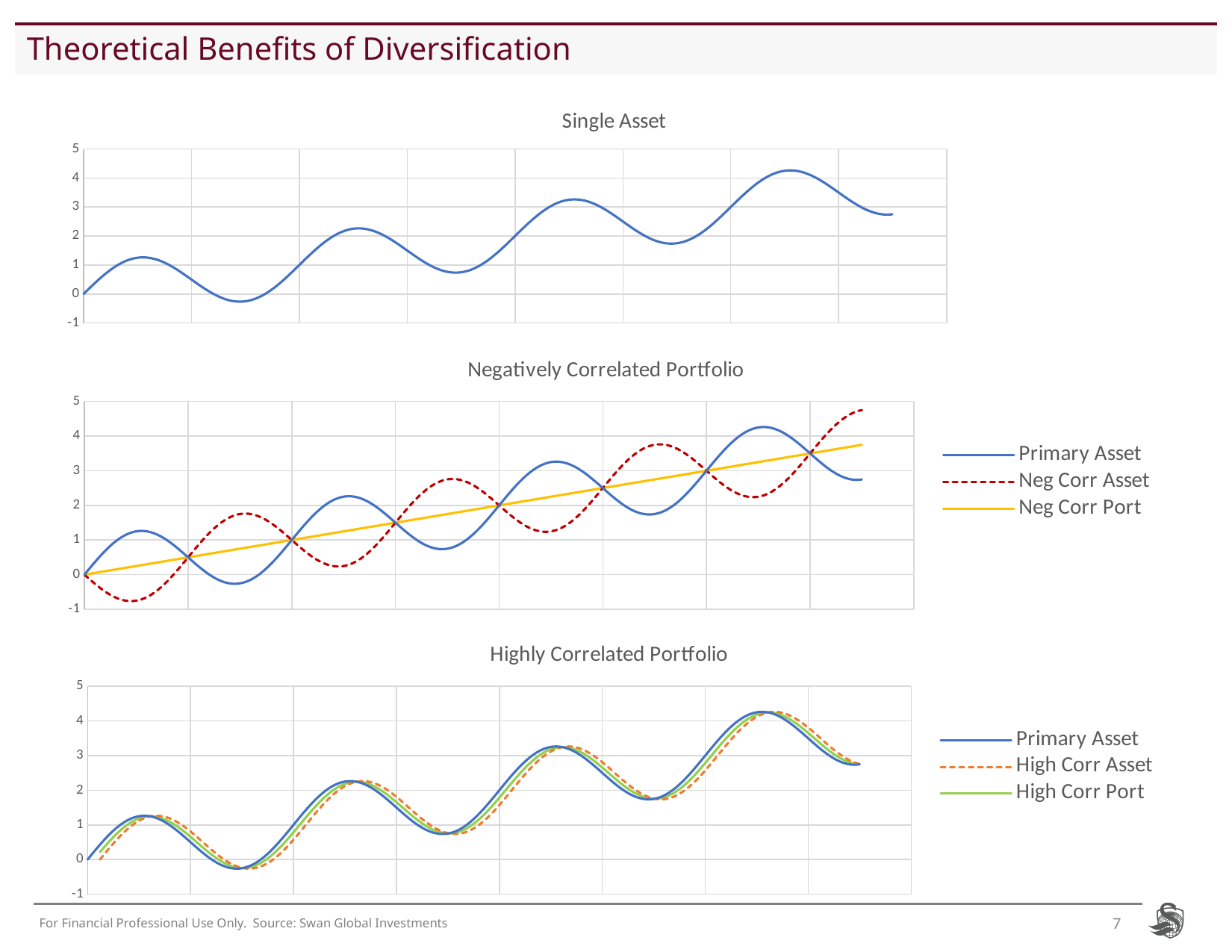
What is the highest value shown on the y axis of the "Single Asset" chart? 5 How many series does the legend of the "Negatively Correlated Portfolio" chart list? 3 In the "Highly Correlated Portfolio" chart, which series is drawn as a green solid line? High Corr Port In the "Negatively Correlated Portfolio" chart, is the lowest point of the Neg Corr Asset line greater or less than 0? less In the "Single Asset" chart, does the line generally rise or fall from left to right? rise In the "Single Asset" chart, is the highest peak of the line greater or less than 4? greater In the "Highly Correlated Portfolio" chart, is the final value of the Primary Asset line greater or less than 2? greater How many series does the legend of the "Highly Correlated Portfolio" chart list? 3 What kind of chart is the "Single Asset" chart? line chart In the "Negatively Correlated Portfolio" chart, which series is drawn as a red dashed line? Neg Corr Asset In the "Negatively Correlated Portfolio" chart, does the Neg Corr Port line rise or fall from left to right? rise